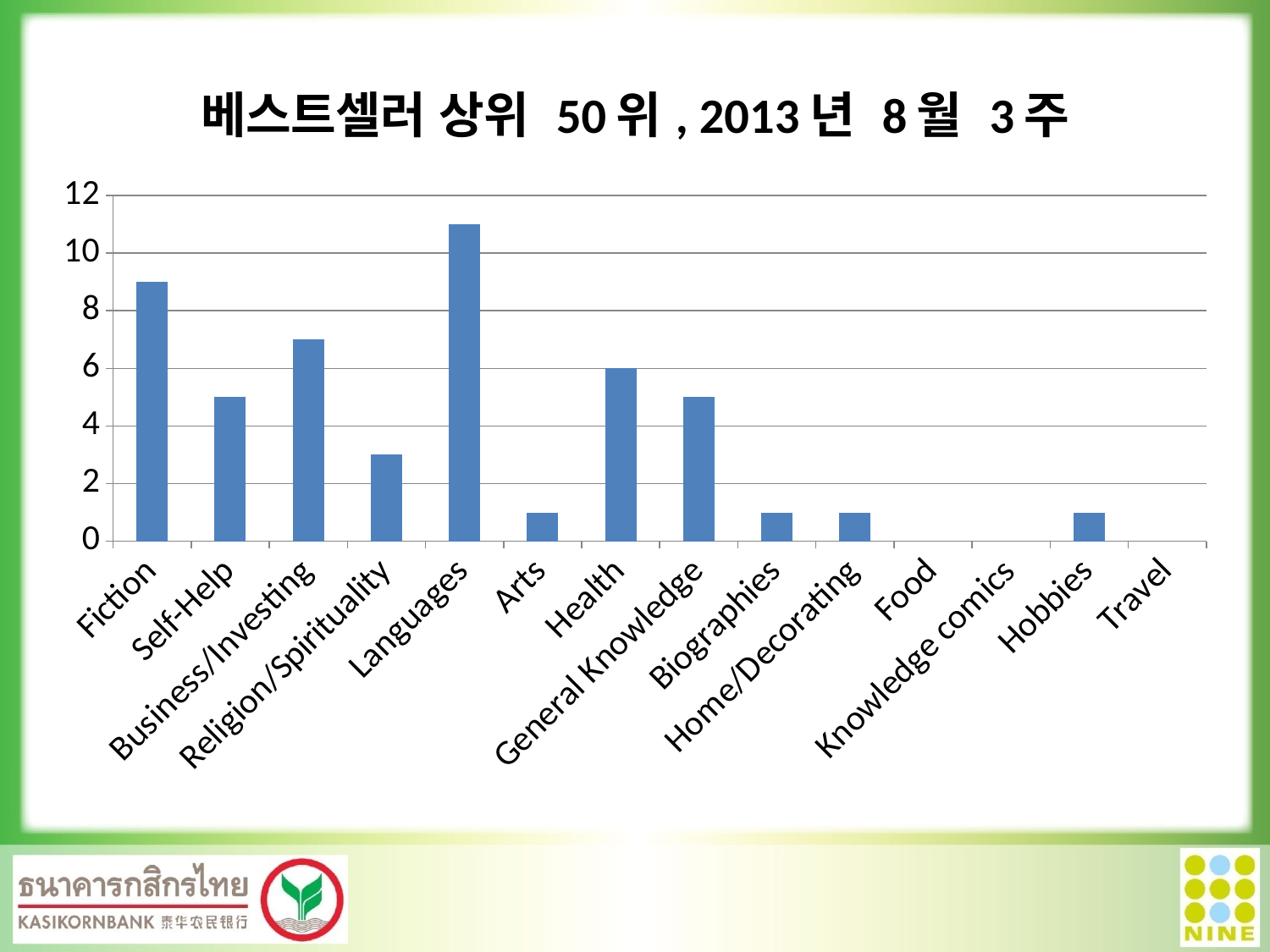
Is the value for Business/Investing greater or less than 6? greater What kind of chart is shown on the slide? bar chart Which is larger, the value for Languages or the value for Fiction? Languages How many categories in the chart have a value of 0? 3 Is the value for Fiction greater or less than 8? greater Which category has the highest bar in the chart? Languages Is the value for Languages greater or less than 10? greater Which is larger, the value for Fiction or the value for Self-Help? Fiction What is the value for Health in the chart? 6 How many categories are shown on the x axis of the chart? 14 What is the value for Food in the chart? 0